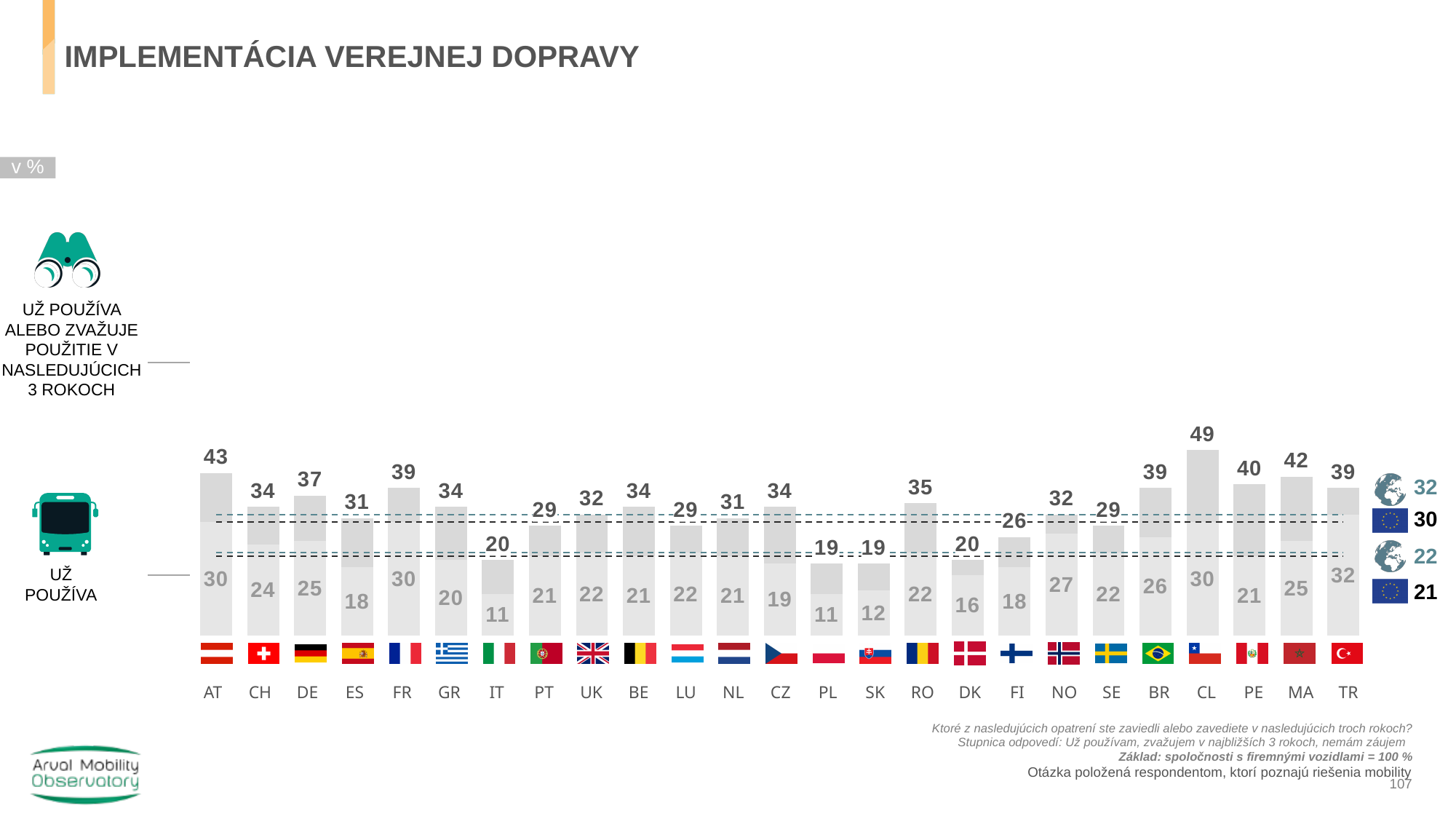
What is the 'Už používa' value for NO? 27 What kind of chart is shown on the slide? bar chart Which country has the highest 'Už používa' value? TR What is the value for CL for 'Už používa alebo zvažuje použitie v nasledujúcich 3 rokoch'? 49 How many countries are shown on the x axis? 25 What is the difference between the 'Už používa alebo zvažuje' value and the 'Už používa' value for AT? 13 Which country has the highest value for 'Už používa alebo zvažuje použitie v nasledujúcich 3 rokoch'? CL What is the global reference value shown for 'Už používa'? 22 Which is larger: the 'Už používa alebo zvažuje' value for DE or for FR? FR What is the 'Už používa' value for IT? 11 What is the EU reference value shown for 'Už používa alebo zvažuje použitie v nasledujúcich 3 rokoch'? 30 Is the 'Už používa alebo zvažuje' value for PL greater or less than 30? less